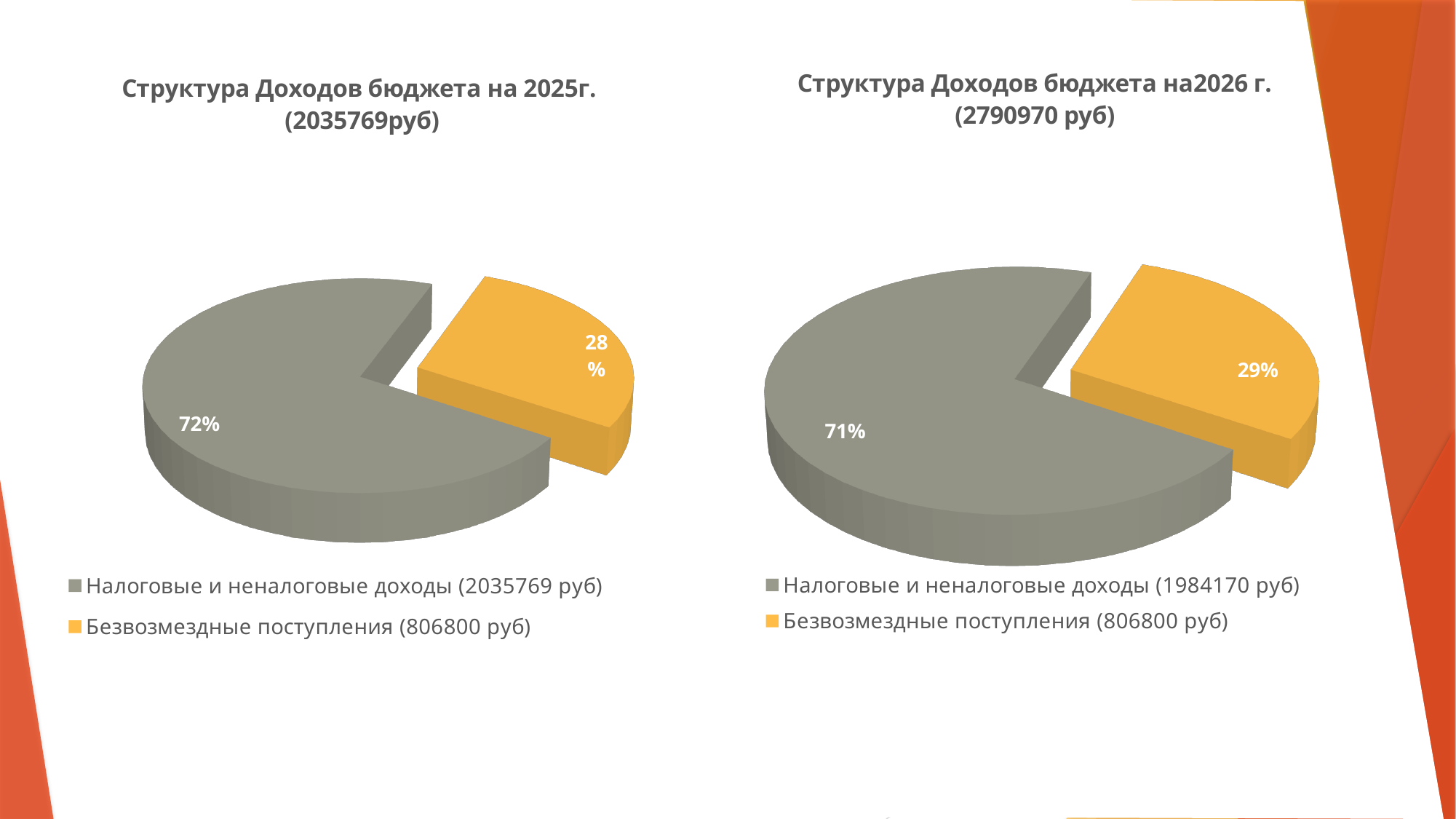
In the left chart (Структура Доходов бюджета на 2025г.), which category has the largest slice? Налоговые и неналоговые доходы In the right chart (Структура Доходов бюджета на 2026 г.), which category has the smallest slice? Безвозмездные поступления In the right chart (Структура Доходов бюджета на 2026 г.), what share of the pie is Налоговые и неналоговые доходы? 71% What is the title of the right chart? Структура Доходов бюджета на2026 г. (2790970 руб) In the left chart (Структура Доходов бюджета на 2025г.), what share of the pie is Безвозмездные поступления? 28% What kind of chart is the left chart (Структура Доходов бюджета на 2025г.)? Pie chart In the left chart (Структура Доходов бюджета на 2025г.), what is the difference in percentage points between the Налоговые и неналоговые доходы slice and the Безвозмездные поступления slice? 44 percentage points In the left chart (Структура Доходов бюджета на 2025г.), what share of the pie is Налоговые и неналоговые доходы? 72% How many slices does the right chart (Структура Доходов бюджета на 2026 г.) have? 2 In the right chart (Структура Доходов бюджета на 2026 г.), which is larger: Налоговые и неналоговые доходы or Безвозмездные поступления? Налоговые и неналоговые доходы In the left chart (Структура Доходов бюджета на 2025г.), what colour is the Безвозмездные поступления slice? Orange